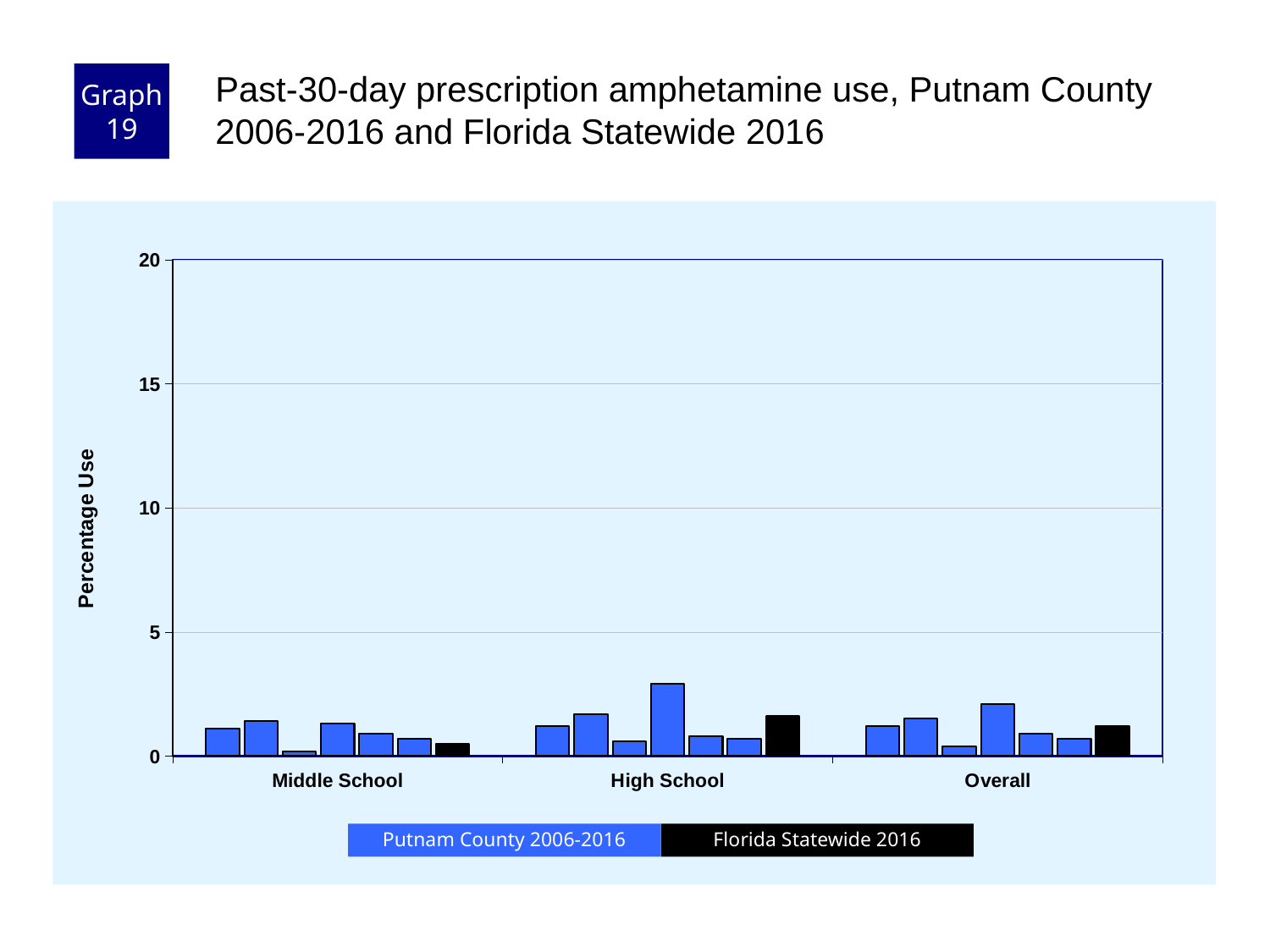
Is the Florida Statewide 2016 value for High School greater or less than 5? less What is the label on the y axis? Percentage Use Which category has the lowest Florida Statewide 2016 bar? Middle School Is the Florida Statewide 2016 value for Overall greater or less than 5? less Which category group contains the tallest bar on the chart? High School How many school-level categories are shown along the x axis? 3 Which is larger, the Florida Statewide 2016 bar for High School or the Florida Statewide 2016 bar for Middle School? High School Is the tallest bar in the High School group greater or less than 5? less What kind of chart is shown on the slide? bar chart How many series does the legend list? 2 Which is larger, the Florida Statewide 2016 bar for Overall or the Florida Statewide 2016 bar for Middle School? Overall Which series is shown in black in the legend? Florida Statewide 2016